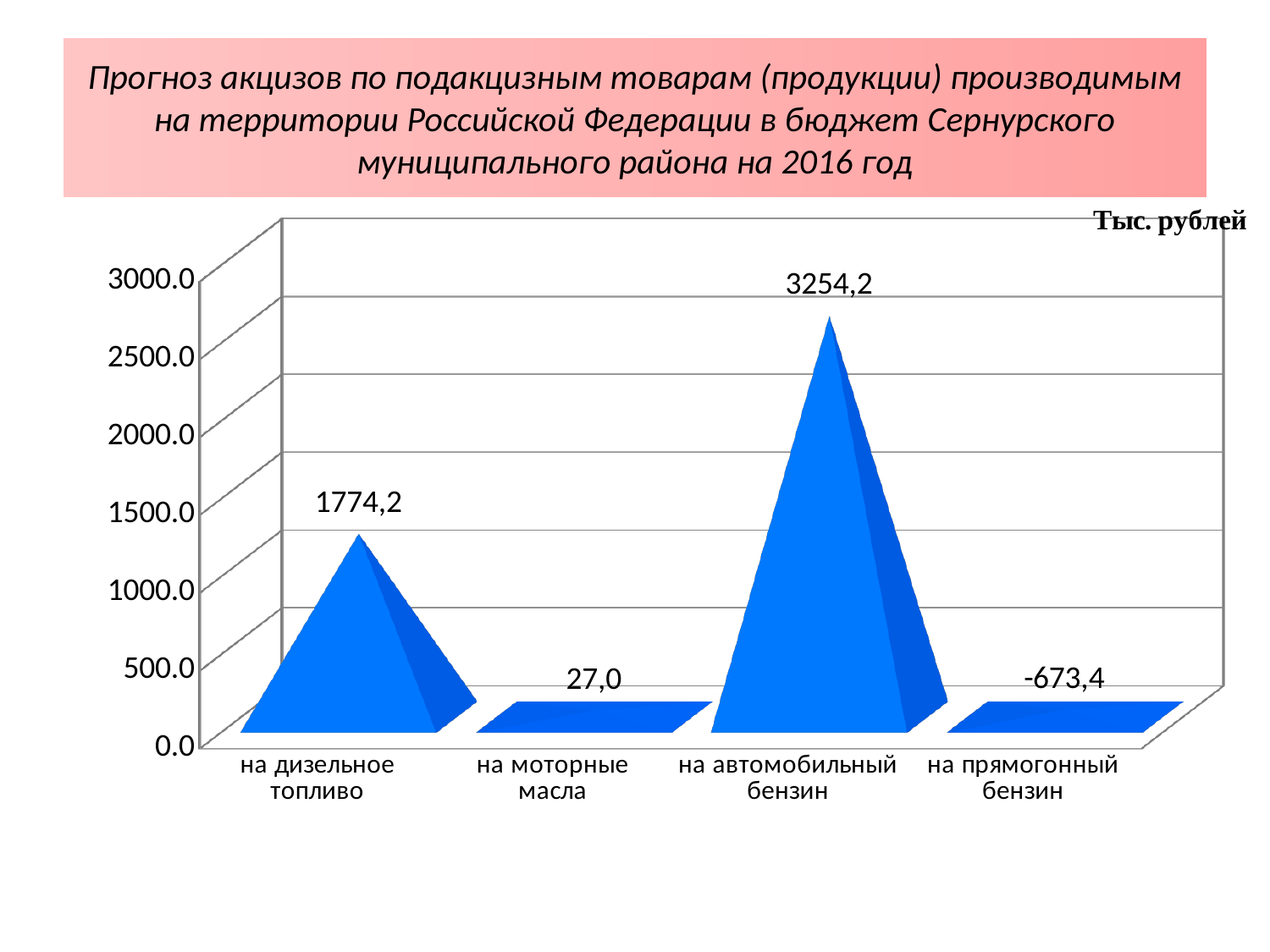
What is the value for «на дизельное топливо»? 1774,2 Which category has the lowest value? на прямогонный бензин What is the value for «на прямогонный бензин»? -673,4 What is the difference between the values for «на автомобильный бензин» and «на дизельное топливо»? 1480,0 What is the difference between the values for «на дизельное топливо» and «на моторные масла»? 1747,2 Which category has the highest value? на автомобильный бензин What kind of chart is shown on the slide? bar chart What is the value for «на автомобильный бензин»? 3254,2 What is the value for «на моторные масла»? 27,0 How many categories are shown on the x axis? 4 What unit is indicated in the top right corner of the chart? Тыс. рублей Which is larger: the value for «на дизельное топливо» or the value for «на моторные масла»? на дизельное топливо